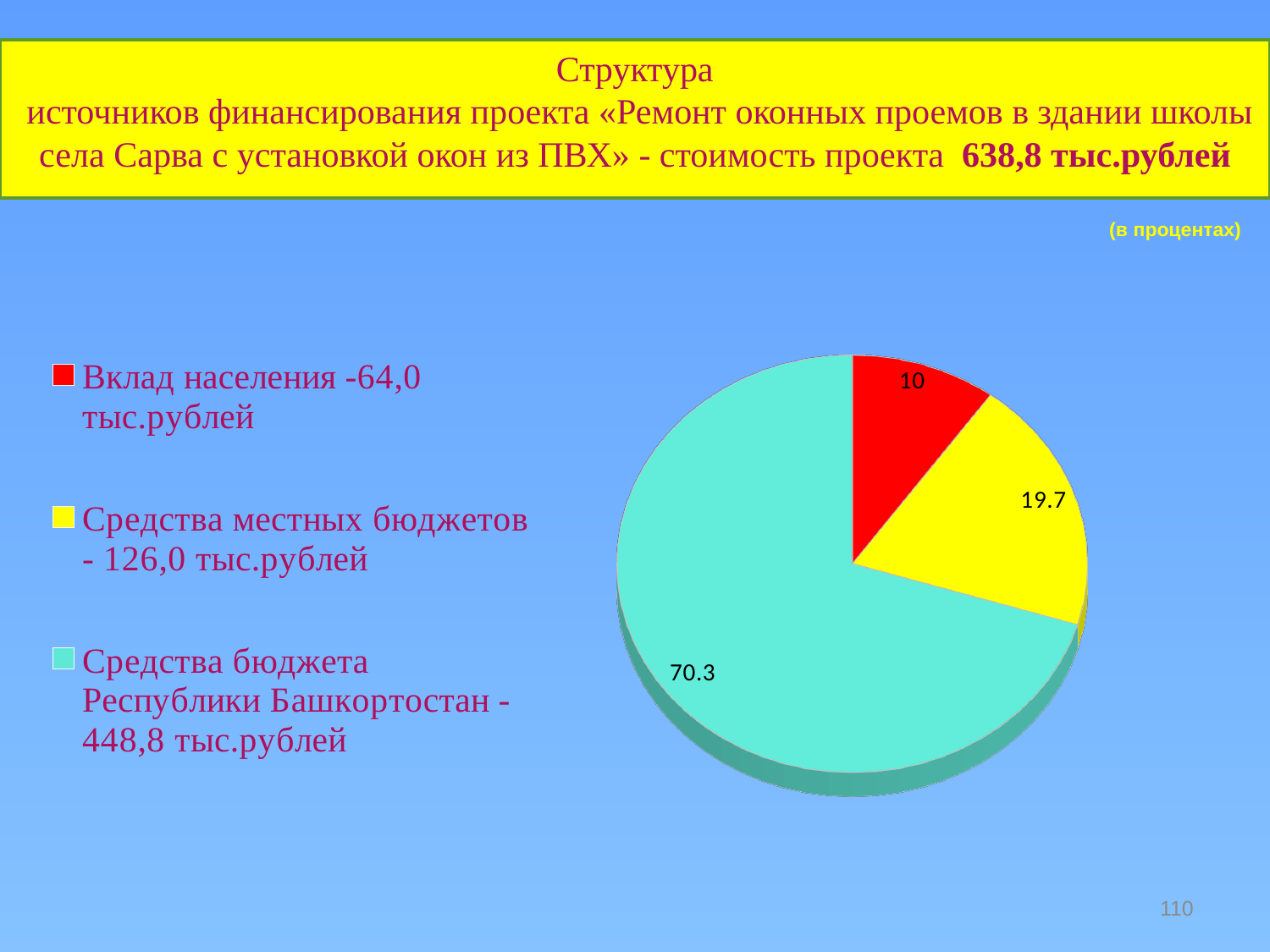
What colour is the slice for "Средства местных бюджетов"? yellow What percentage is shown for the slice "Средства местных бюджетов"? 19.7 According to the legend, what amount in тыс.рублей corresponds to "Вклад населения"? 64,0 тыс.рублей What percentage is shown for the slice "Средства бюджета Республики Башкортостан"? 70.3 How many slices does the pie chart have? 3 What percentage is shown for the slice "Вклад населения"? 10 What kind of chart is shown on the slide? pie chart What is the difference in percentage points between the "Средства местных бюджетов" slice and the "Вклад населения" slice? 9.7 Which funding source has the smallest share of the pie? Вклад населения Which is larger: the share for "Средства местных бюджетов" or the share for "Вклад населения"? Средства местных бюджетов Which funding source has the largest share of the pie? Средства бюджета Республики Башкортостан How many entries does the legend list? 3